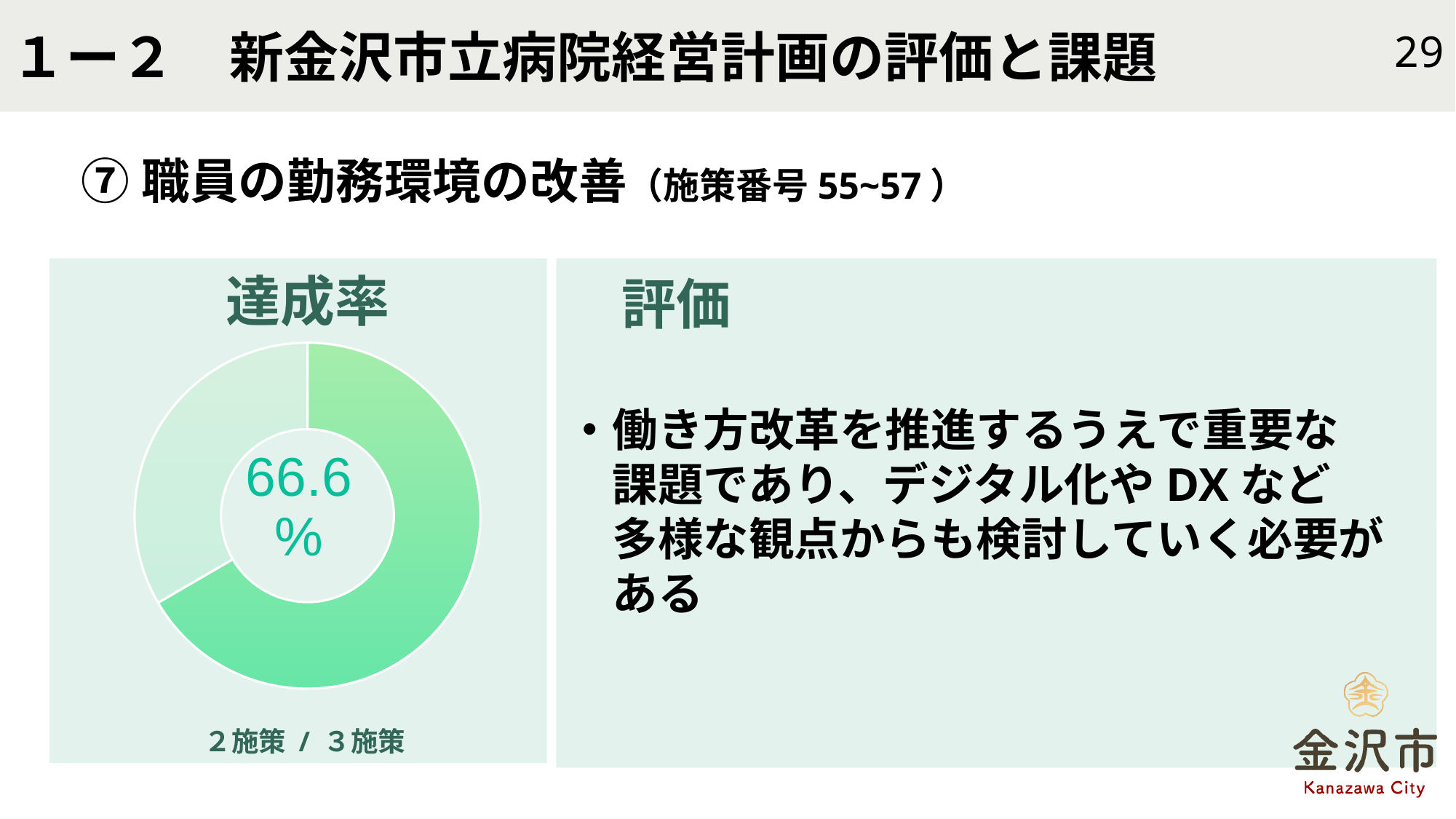
Based on the label 2施策 / 3施策 below the chart, how many measures were not achieved? 1施策 According to the label below the 達成率 chart, how many measures are there in total? 3施策 What kind of chart is shown under the heading 達成率? donut chart In the 達成率 donut chart, which slice is larger, the darker green one or the lighter green one? the darker green one Is the 達成率 value shown in the donut chart greater or less than 50%? greater How many slices does the 達成率 donut chart have? 2 What value is printed in the centre of the 達成率 donut chart? 66.6% According to the label below the 達成率 chart, how many measures were achieved? 2施策 Where on the donut chart is the 66.6% value displayed? in the centre of the donut What share of the 達成率 donut does the darker green (achieved) slice represent? 66.6% What is the title printed above the donut chart? 達成率